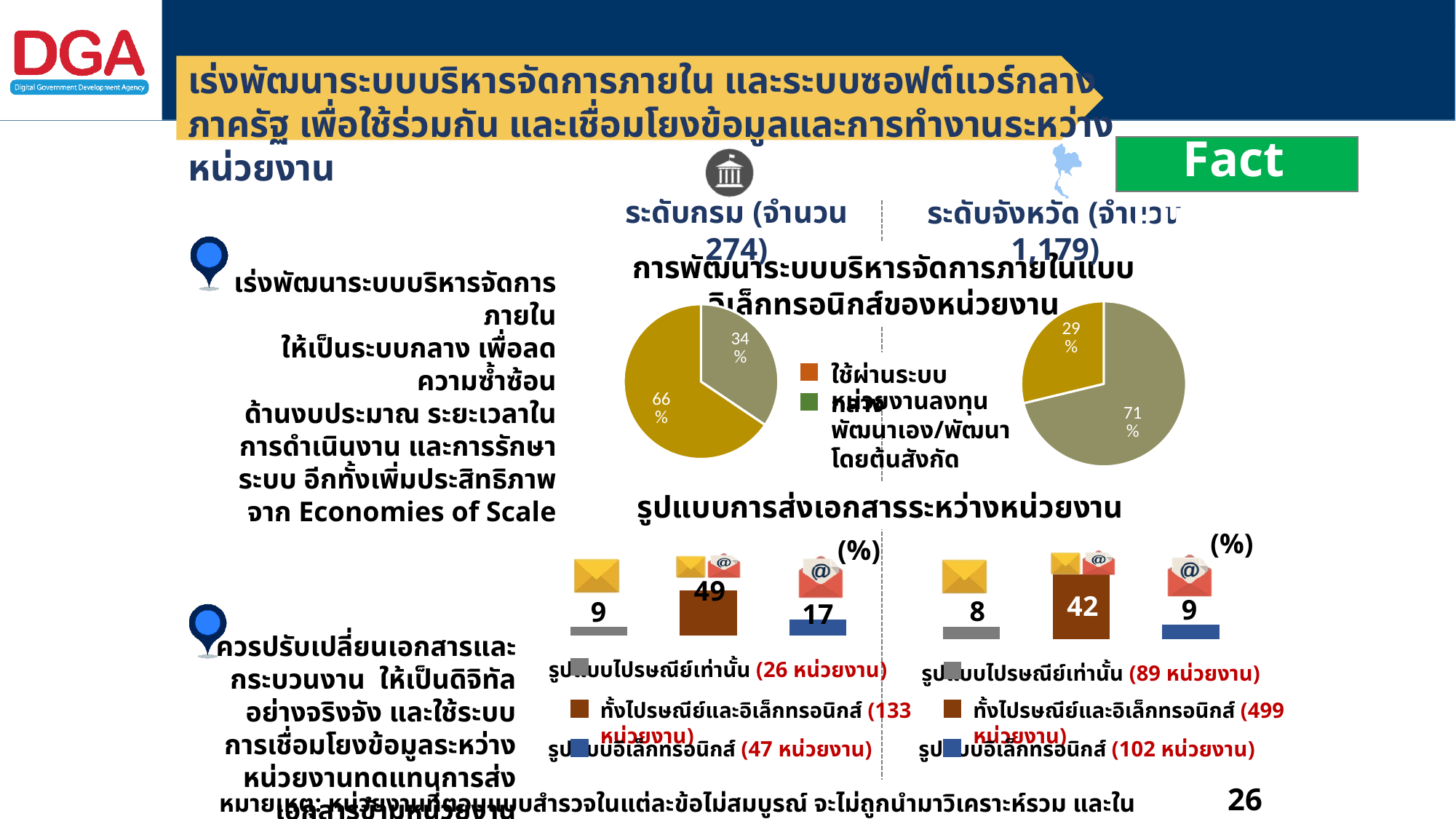
In the department-level bar chart for รูปแบบการส่งเอกสารระหว่างหน่วยงาน, what is the value for รูปแบบไปรษณีย์เท่านั้น? 9 In the department-level bar chart for รูปแบบการส่งเอกสารระหว่างหน่วยงาน, which is larger: รูปแบบไปรษณีย์เท่านั้น or รูปแบบอิเล็กทรอนิกส์? รูปแบบอิเล็กทรอนิกส์ In the province-level (ระดับจังหวัด) pie chart, what is the larger slice's percentage? 71% What kind of chart is used for การพัฒนาระบบบริหารจัดการภายในแบบอิเล็กทรอนิกส์ของหน่วยงาน? Pie chart In the province-level bar chart for รูปแบบการส่งเอกสารระหว่างหน่วยงาน, which category has the highest value? ทั้งไปรษณีย์และอิเล็กทรอนิกส์ In the province-level bar chart for รูปแบบการส่งเอกสารระหว่างหน่วยงาน, what is the value for รูปแบบอิเล็กทรอนิกส์? 9 In the department-level (ระดับกรม) pie chart, what is the smaller slice's percentage? 34% In the department-level bar chart for รูปแบบการส่งเอกสารระหว่างหน่วยงาน, what is the difference between ทั้งไปรษณีย์และอิเล็กทรอนิกส์ and รูปแบบอิเล็กทรอนิกส์? 32 In the department-level bar chart for รูปแบบการส่งเอกสารระหว่างหน่วยงาน, what is the value for ทั้งไปรษณีย์และอิเล็กทรอนิกส์? 49 In the province-level (ระดับจังหวัด) pie chart, what is the smaller slice's percentage? 29% In the department-level (ระดับกรม) pie chart, what is the larger slice's percentage? 66% How many categories are shown in the province-level bar chart for รูปแบบการส่งเอกสารระหว่างหน่วยงาน? 3